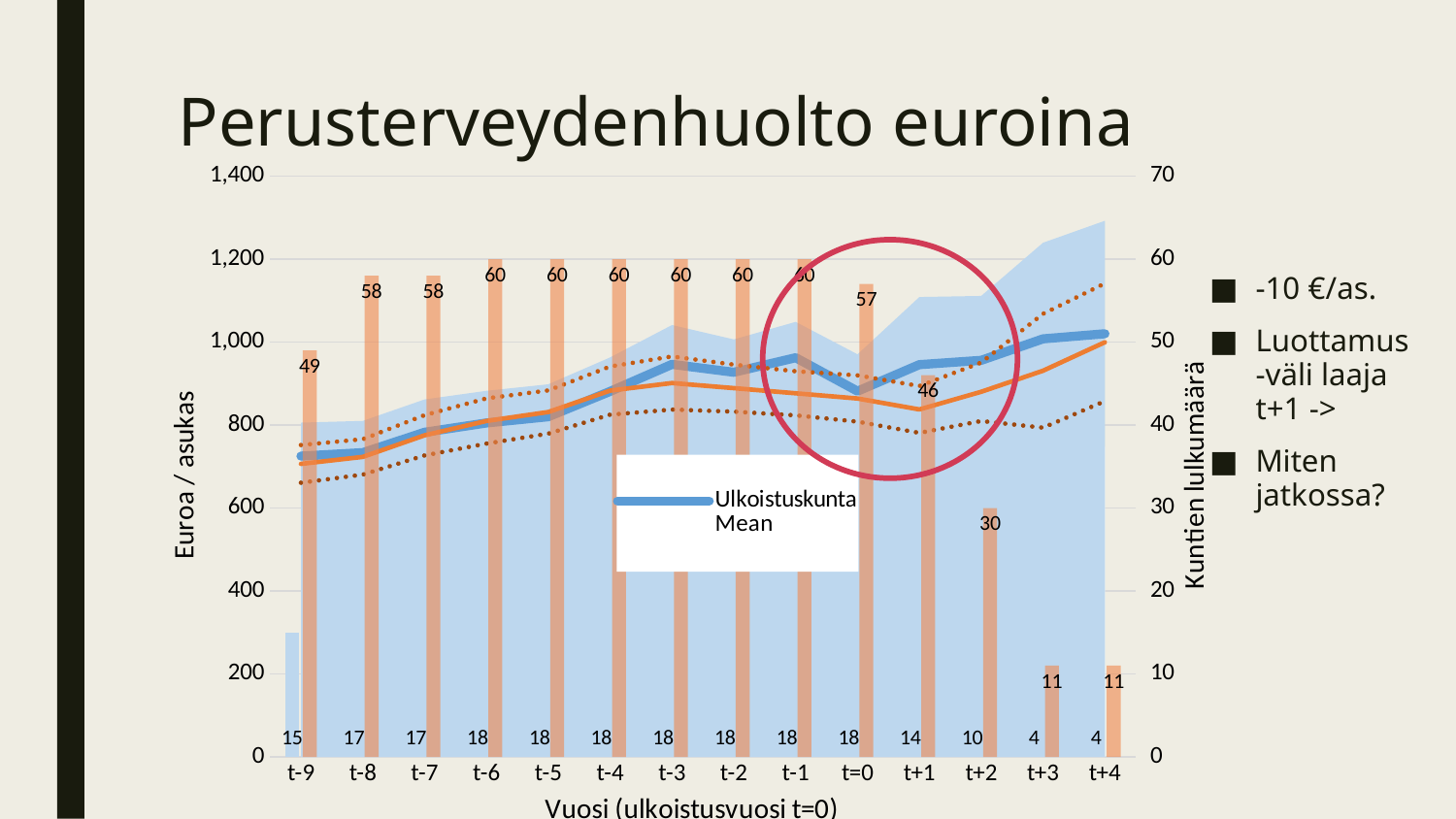
What is the value of the orange bar at t+2? 30 What is the title of the chart? Perusterveydenhuolto euroina What is the value of the orange bar at t-9? 49 What is the value of the orange bar at t+1? 46 What is the difference between the orange bar values at t-8 and t+2? 28 What is the label of the left vertical axis? Euroa / asukas Does the Ulkoistuskunta Mean line rise or fall overall from t-9 to t+4? rises How many year categories are shown on the x axis? 14 What is the difference between the orange bar values at t=0 and t+1? 11 What is the lowest value labelled on the orange bars? 11 Which has the larger orange bar value, t-9 or t+1? t-9 Is the Ulkoistuskunta Mean value at t-9 greater or less than 800? less